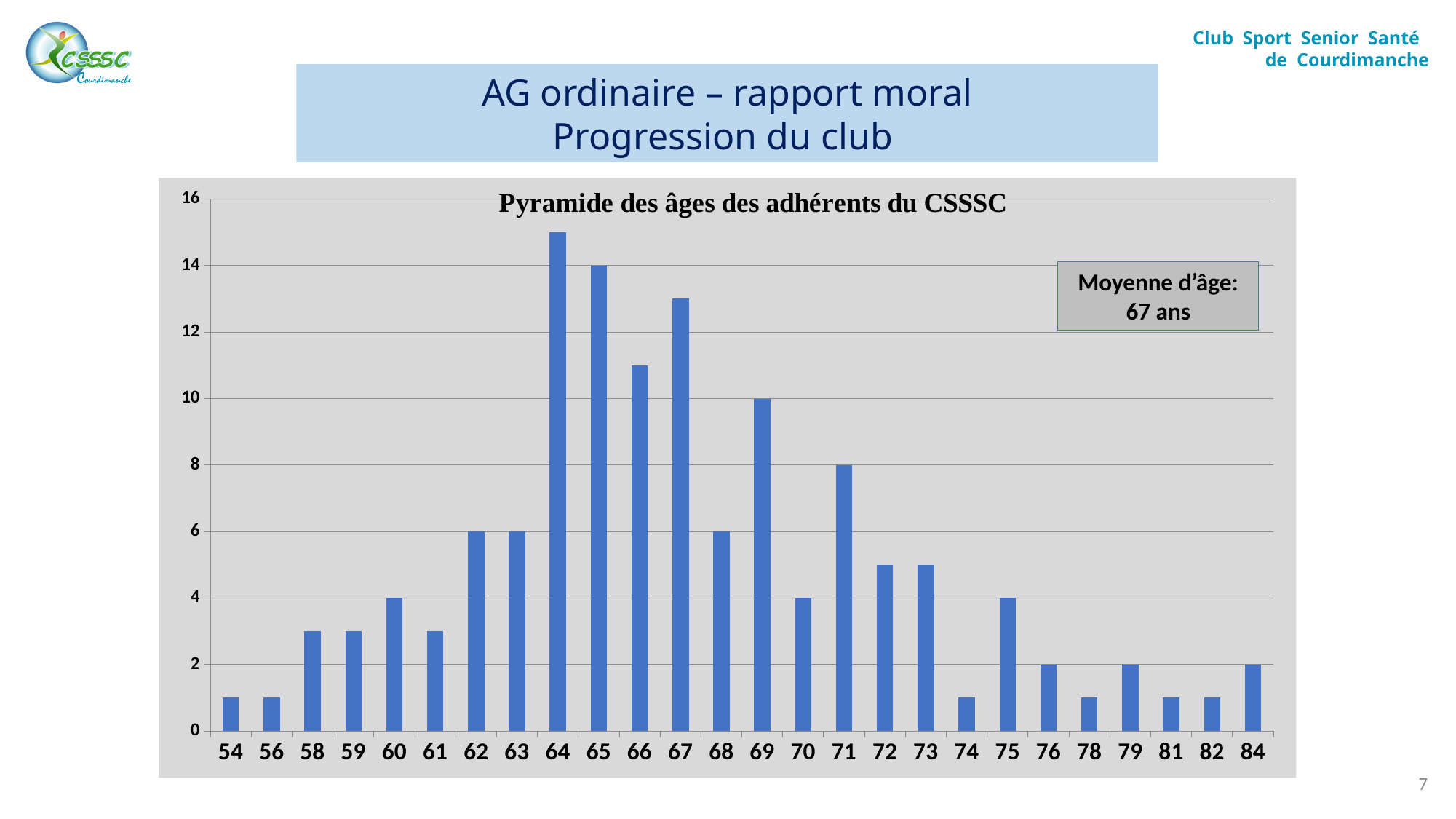
What is the value for age 60? 4 What is the title of the chart? Pyramide des âges des adhérents du CSSSC Which is larger, the value for age 71 or the value for age 72? 71 Which age has the highest number of members? 64 What is the difference between the values for age 65 and age 70? 10 What is the value for age 71? 8 Is the value for age 67 greater or less than 12? greater What is the value for age 65? 14 How many age categories are shown on the x axis? 26 Is the value for age 64 greater or less than 14? greater What is the value for age 69? 10 What kind of chart is shown on the slide? bar chart